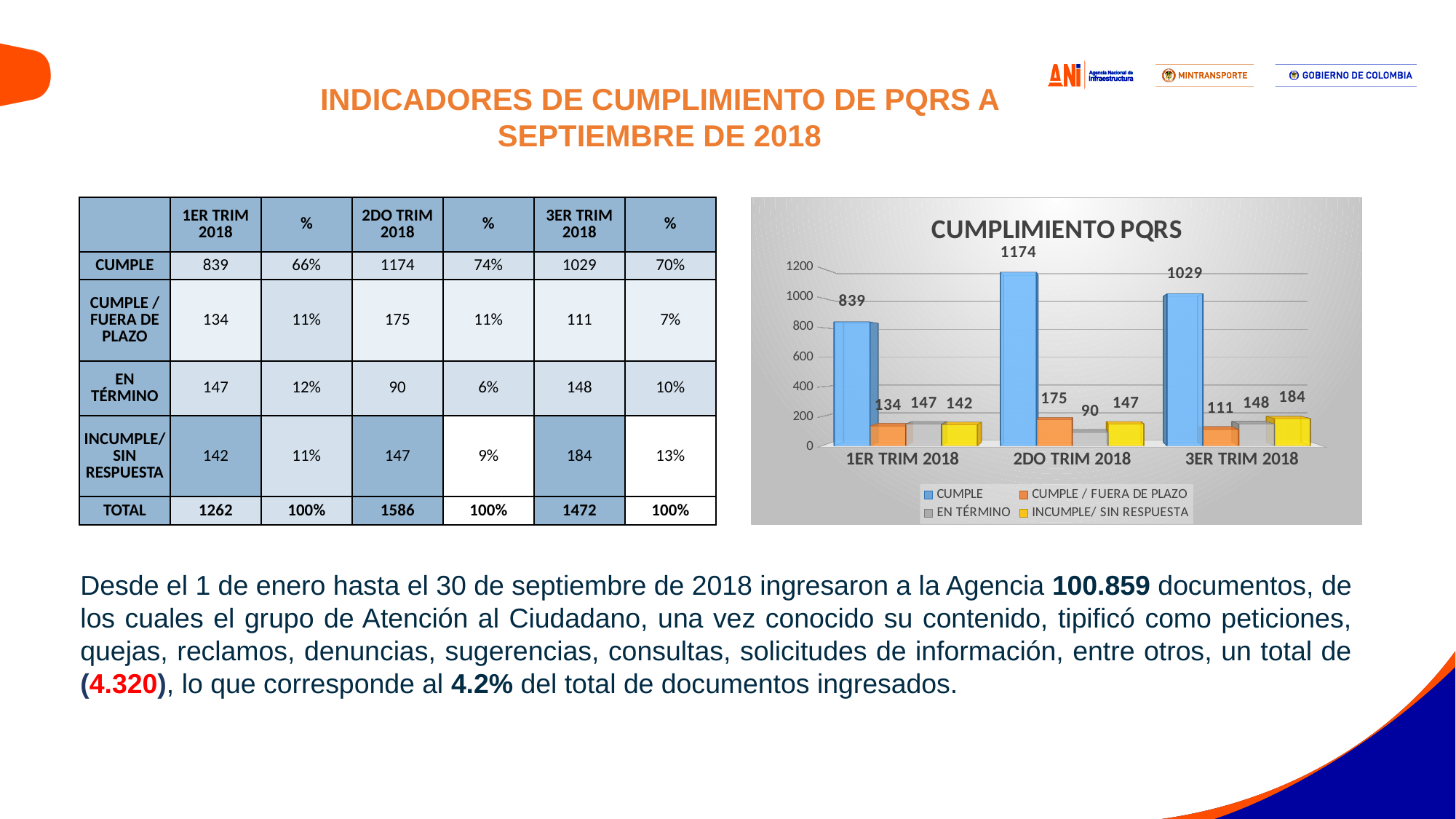
Which quarter has the highest CUMPLE value? 2DO TRIM 2018 What is the value of INCUMPLE/ SIN RESPUESTA for 3ER TRIM 2018? 184 What is the value of CUMPLE for 2DO TRIM 2018? 1174 What type of chart is shown on the slide? bar chart What is the value of EN TÉRMINO for 2DO TRIM 2018? 90 What is the difference between the CUMPLE values for 2DO TRIM 2018 and 3ER TRIM 2018? 145 Which quarter has the lowest EN TÉRMINO value? 2DO TRIM 2018 What is the title of the chart? CUMPLIMIENTO PQRS How many categories are shown on the x axis of the chart? 3 How many series does the chart legend list? 4 Does the INCUMPLE/ SIN RESPUESTA value rise or fall from 2DO TRIM 2018 to 3ER TRIM 2018? rise Which is larger, CUMPLE / FUERA DE PLAZO for 1ER TRIM 2018 or for 2DO TRIM 2018? 2DO TRIM 2018